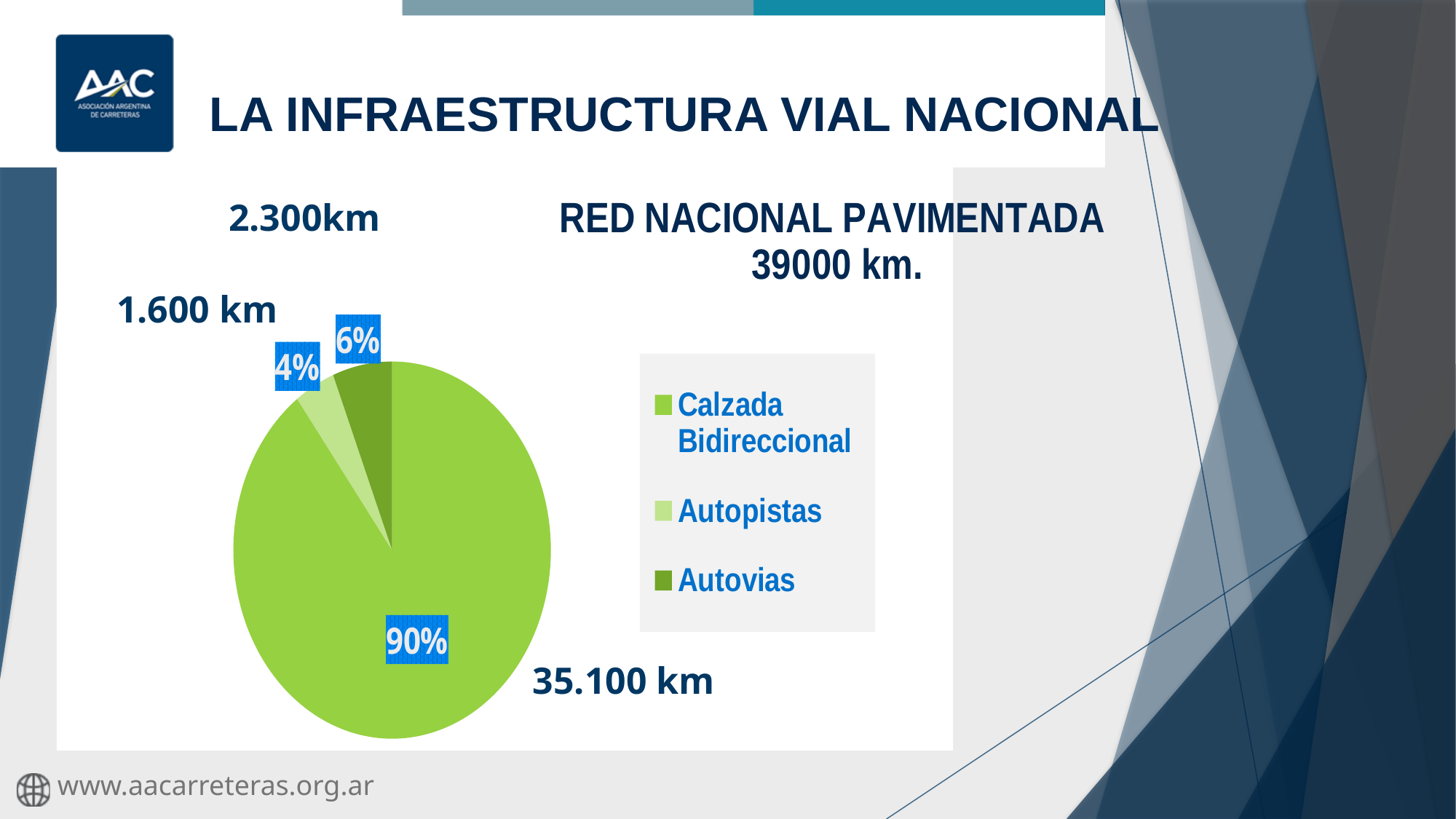
What total length of the paved national network (Red Nacional Pavimentada) is stated on the slide? 39000 km. What is the difference in percentage points between the Autovias slice and the Autopistas slice? 2 What is the difference in percentage points between the Calzada Bidireccional slice and the Autovias slice? 84 What percentage of the pie chart is Autovias? 6% Which category has the smallest slice of the pie chart? Autopistas What type of chart is shown on the slide? pie chart Which category has the largest slice of the pie chart? Calzada Bidireccional Which slice is larger, Autovias or Autopistas? Autovias What length in km is written next to the 90% slice of the pie chart? 35.100 km What percentage of the pie chart is Autopistas? 4% What percentage of the pie chart is Calzada Bidireccional? 90% How many categories does the pie chart show? 3